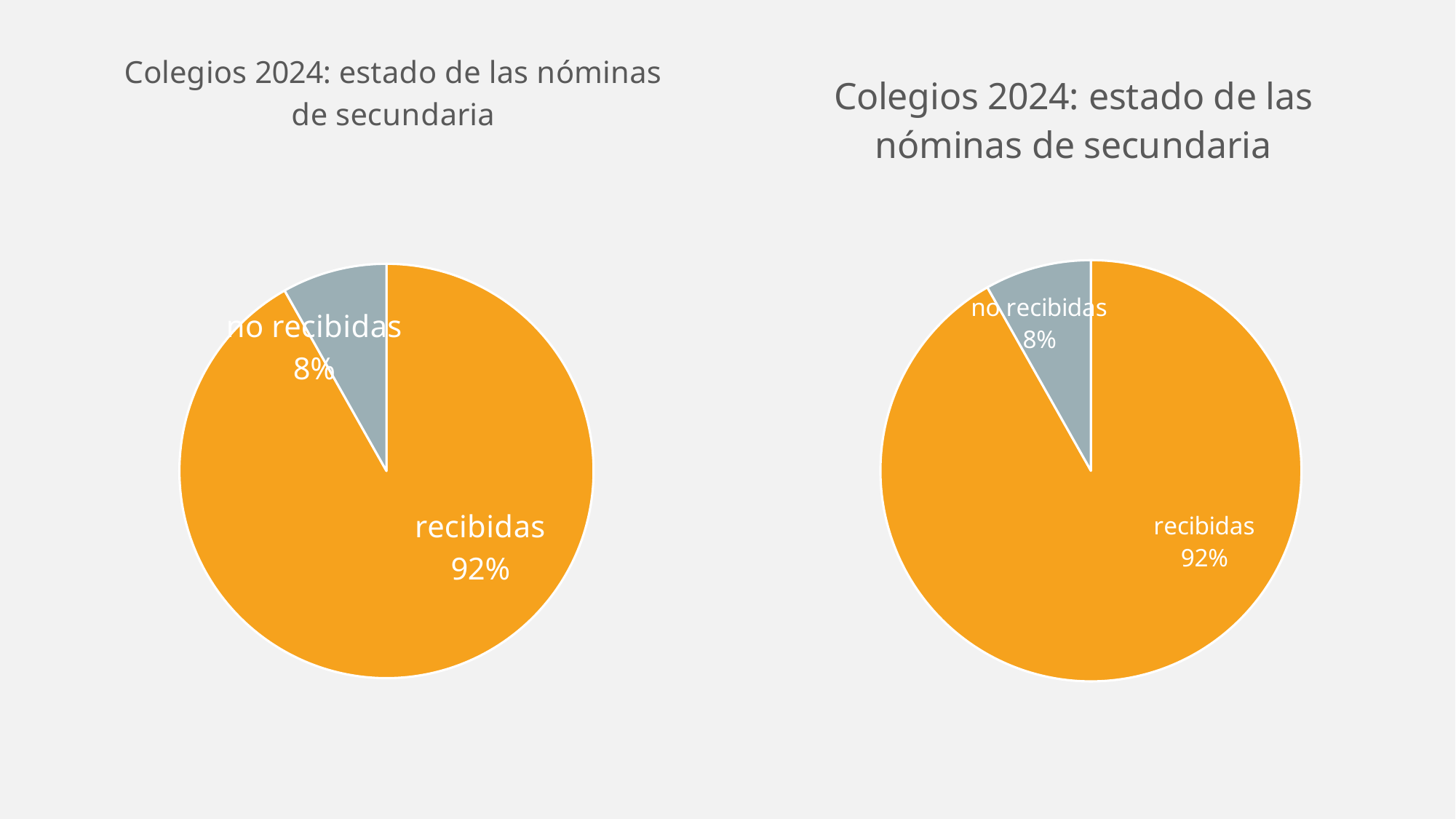
What kind of chart is the chart on the right of the slide? pie chart What is the title of the left chart? Colegios 2024: estado de las nóminas de secundaria In the left pie chart, which slice is the largest? recibidas In the right pie chart, what share of the pie is labelled 'recibidas'? 92% How many slices does the left pie chart have? 2 In the left pie chart, what share of the pie is labelled 'recibidas'? 92% In the right pie chart, which slice is the smallest? no recibidas In the right pie chart, what colour is the 'recibidas' slice? orange In the left pie chart, what is the difference in percentage points between 'recibidas' and 'no recibidas'? 84 In the right pie chart, which is larger, 'recibidas' or 'no recibidas'? recibidas In the left pie chart, what share of the pie is labelled 'no recibidas'? 8%